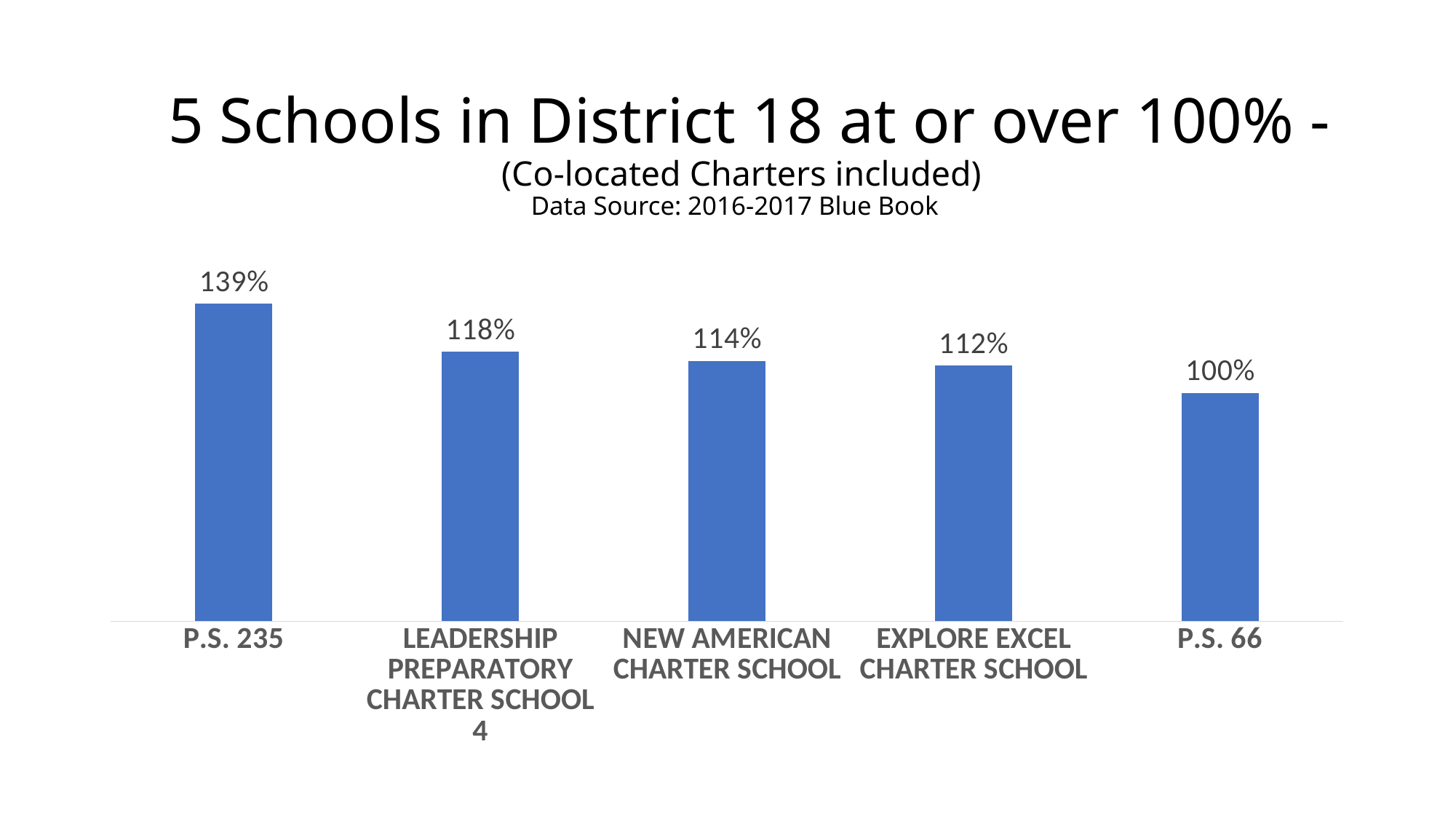
What is the value for Leadership Preparatory Charter School 4? 118% What is the value for Explore Excel Charter School? 112% Which school has the lowest value? P.S. 66 Do the values rise or fall from left to right across the chart? Fall Which school has the highest value? P.S. 235 What is the value for P.S. 66? 100% Which is larger, the value for Leadership Preparatory Charter School 4 or the value for Explore Excel Charter School? Leadership Preparatory Charter School 4 What is the value for P.S. 235? 139% What kind of chart is shown on the slide? Bar chart How many schools are shown in the chart? 5 What is the difference between the values for P.S. 235 and P.S. 66? 39% What is the value for New American Charter School? 114%